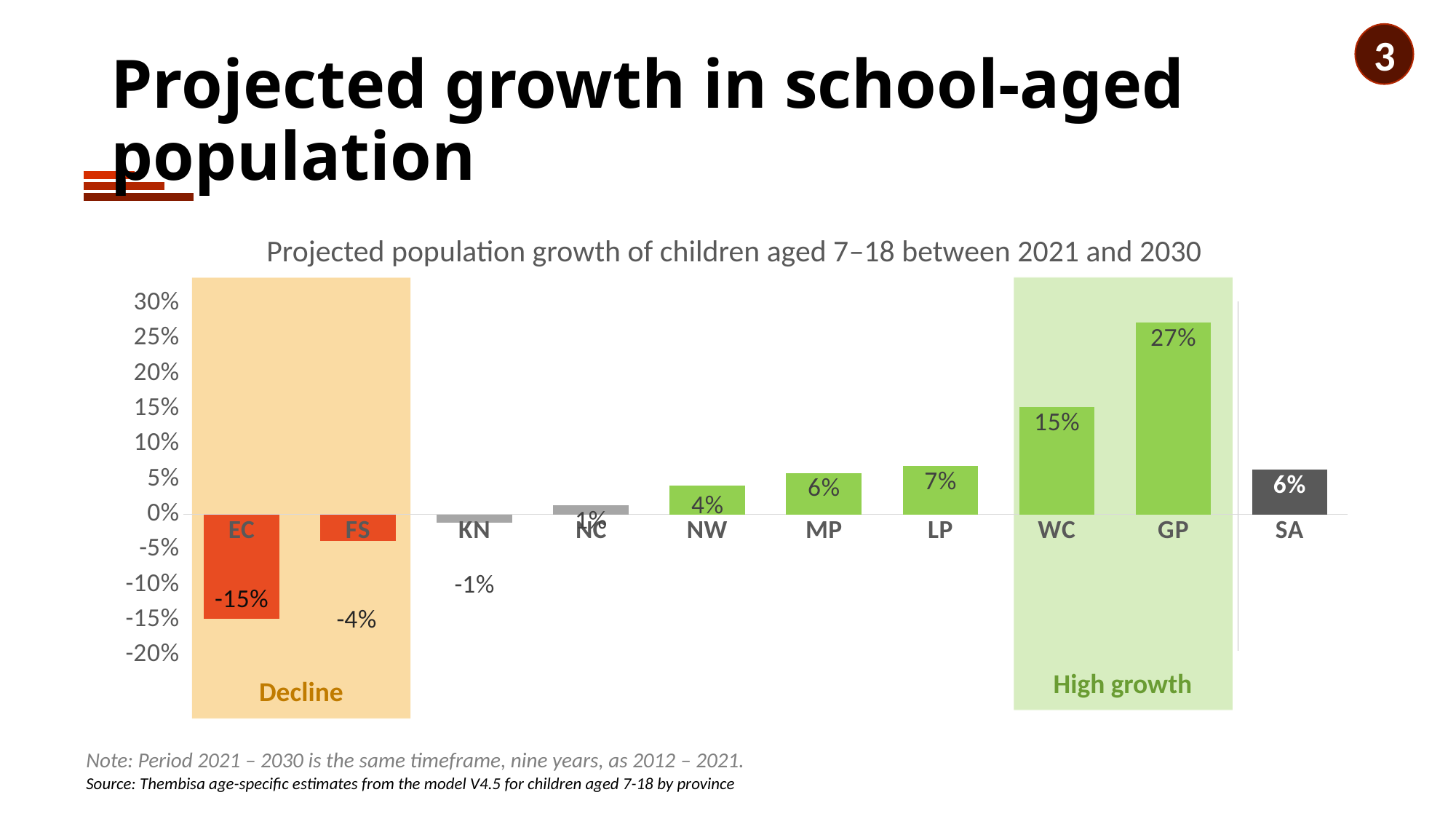
What is the difference between the projected growth for GP and WC? 12 percentage points What is the title of the chart? Projected population growth of children aged 7–18 between 2021 and 2030 Which province has the lowest projected population growth? EC Which has a higher projected growth, LP or MP? LP Which province has the highest projected population growth? GP Is the value for GP greater or less than 25%? greater What is the projected population growth for WC? 15% What is the projected population growth for EC? -15% What is the projected population growth for SA? 6% What kind of chart is shown on the slide? Bar chart How many categories are shown on the x axis of the chart? 10 What is the projected population growth for GP? 27%